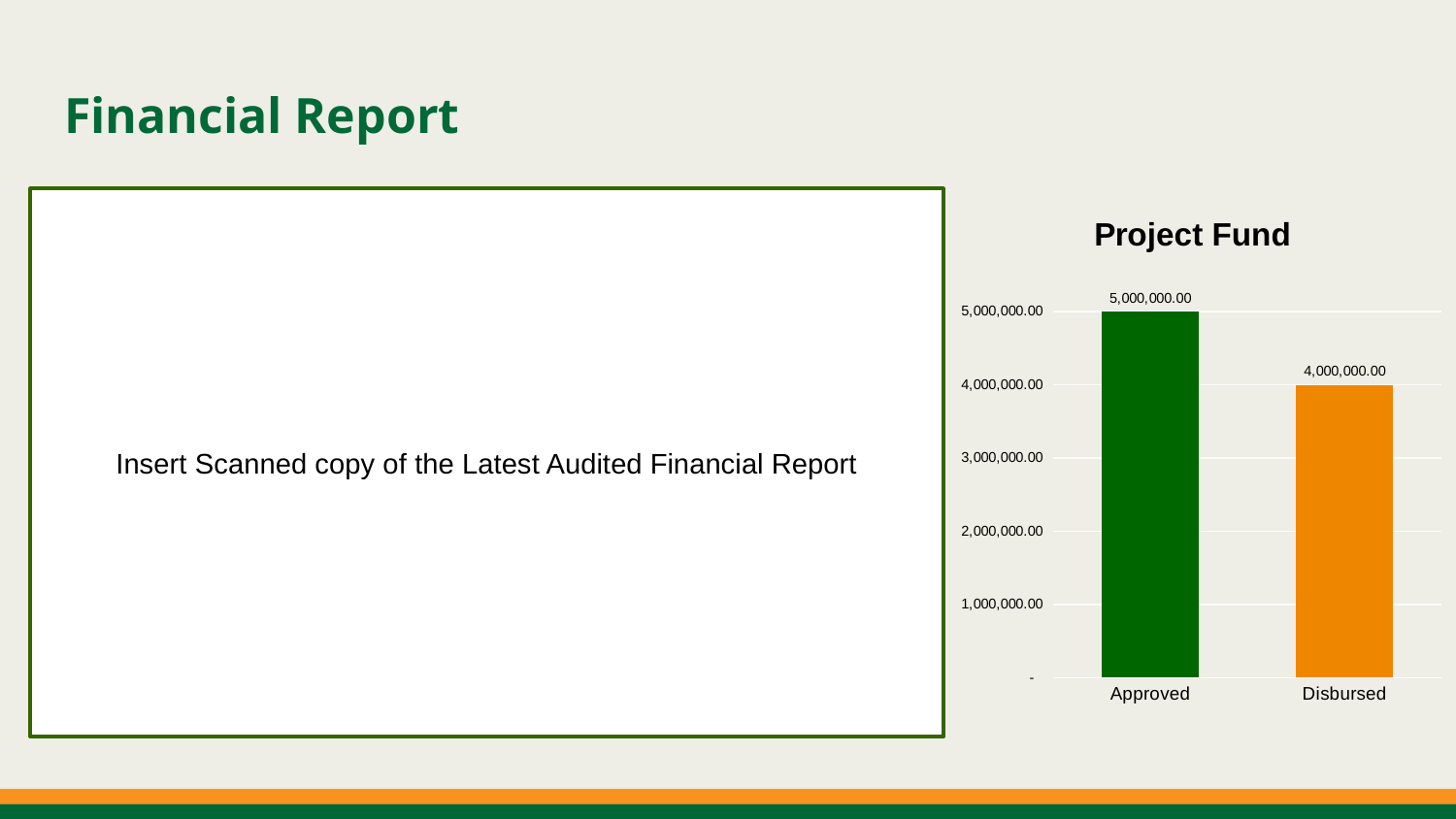
Which is larger in the Project Fund chart, Approved or Disbursed? Approved Which category has the highest value in the Project Fund chart? Approved What is the difference between the Approved and Disbursed values in the Project Fund chart? 1,000,000.00 What is the value for Approved in the Project Fund chart? 5,000,000.00 What colour is the Disbursed bar in the Project Fund chart? orange How many categories are shown in the Project Fund chart? 2 Is the value for Disbursed greater or less than 3,000,000.00? greater Do the values rise or fall from Approved to Disbursed in the Project Fund chart? fall What kind of chart is the Project Fund chart? bar chart What is the value for Disbursed in the Project Fund chart? 4,000,000.00 What is the title of the chart on the slide? Project Fund Which category has the lowest value in the Project Fund chart? Disbursed